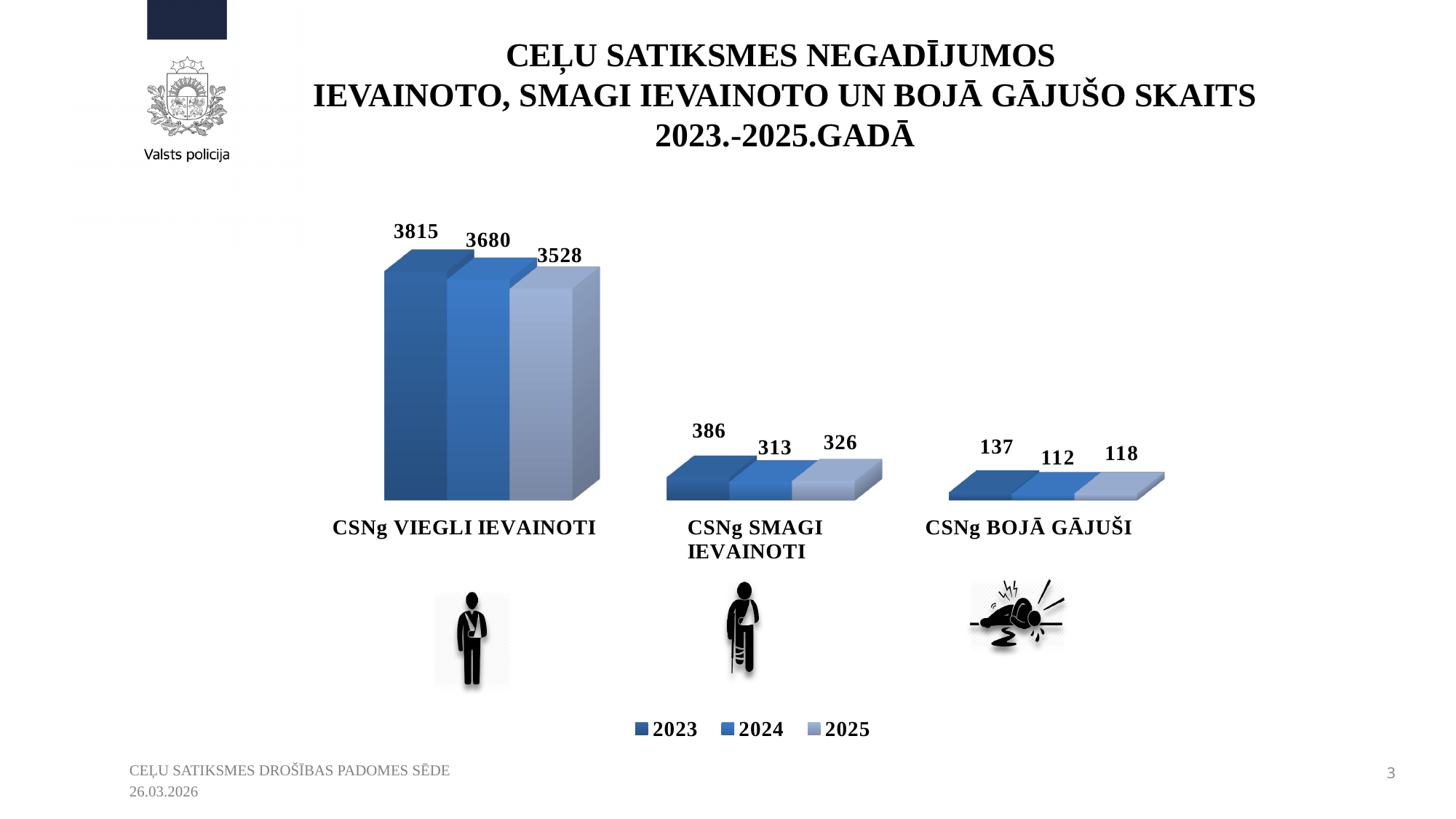
How many categories are shown on the x axis? 3 What is the value for CSNg SMAGI IEVAINOTI in 2024? 313 What is the difference between the 2023 and 2025 values for CSNg VIEGLI IEVAINOTI? 287 What is the value for CSNg VIEGLI IEVAINOTI in 2023? 3815 What kind of chart is shown on the slide? bar chart What is the difference between the 2023 and 2024 values for CSNg BOJĀ GĀJUŠI? 25 Which is larger for CSNg SMAGI IEVAINOTI: the 2024 value or the 2025 value? 2025 Which year has the highest value for CSNg SMAGI IEVAINOTI? 2023 Do the values for CSNg VIEGLI IEVAINOTI rise or fall from 2023 to 2025? fall What is the value for CSNg BOJĀ GĀJUŠI in 2025? 118 How many series does the legend list? 3 Which year has the lowest value for CSNg BOJĀ GĀJUŠI? 2024